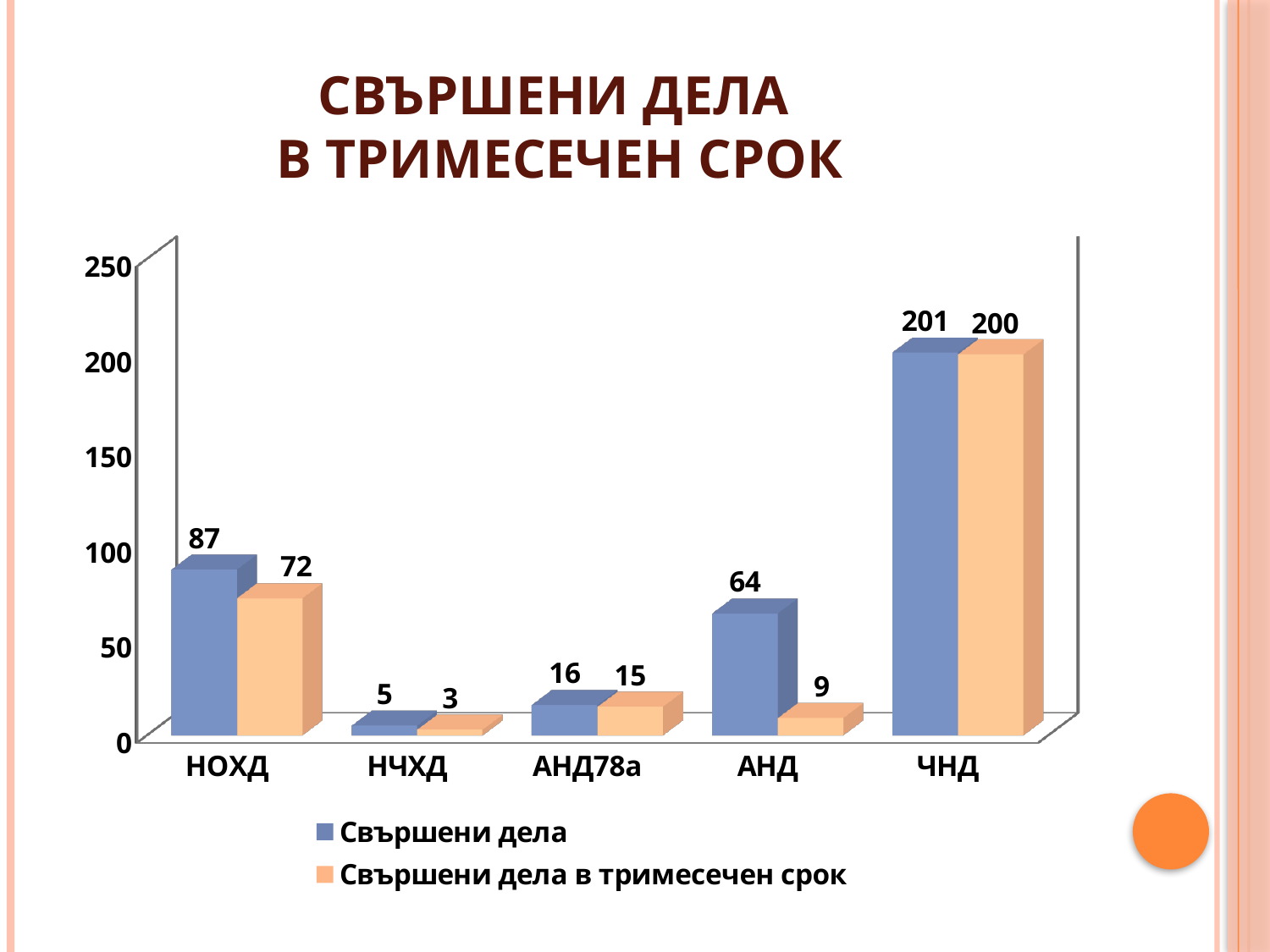
What is the value of "Свършени дела" for НОХД? 87 Which category has the highest value for "Свършени дела"? ЧНД What kind of chart is shown on the slide? Bar chart Which category has the lowest value for "Свършени дела в тримесечен срок"? НЧХД How many categories are shown on the x axis? 5 How many series does the legend list? 2 What is the title of the slide? СВЪРШЕНИ ДЕЛА В ТРИМЕСЕЧЕН СРОК What is the difference between "Свършени дела" for НОХД and for АНД? 23 What is the difference between "Свършени дела" and "Свършени дела в тримесечен срок" for АНД? 55 Which is larger: "Свършени дела" for НОХД or "Свършени дела" for АНД? НОХД What is the value of "Свършени дела в тримесечен срок" for ЧНД? 200 What is the value of "Свършени дела в тримесечен срок" for АНД? 9